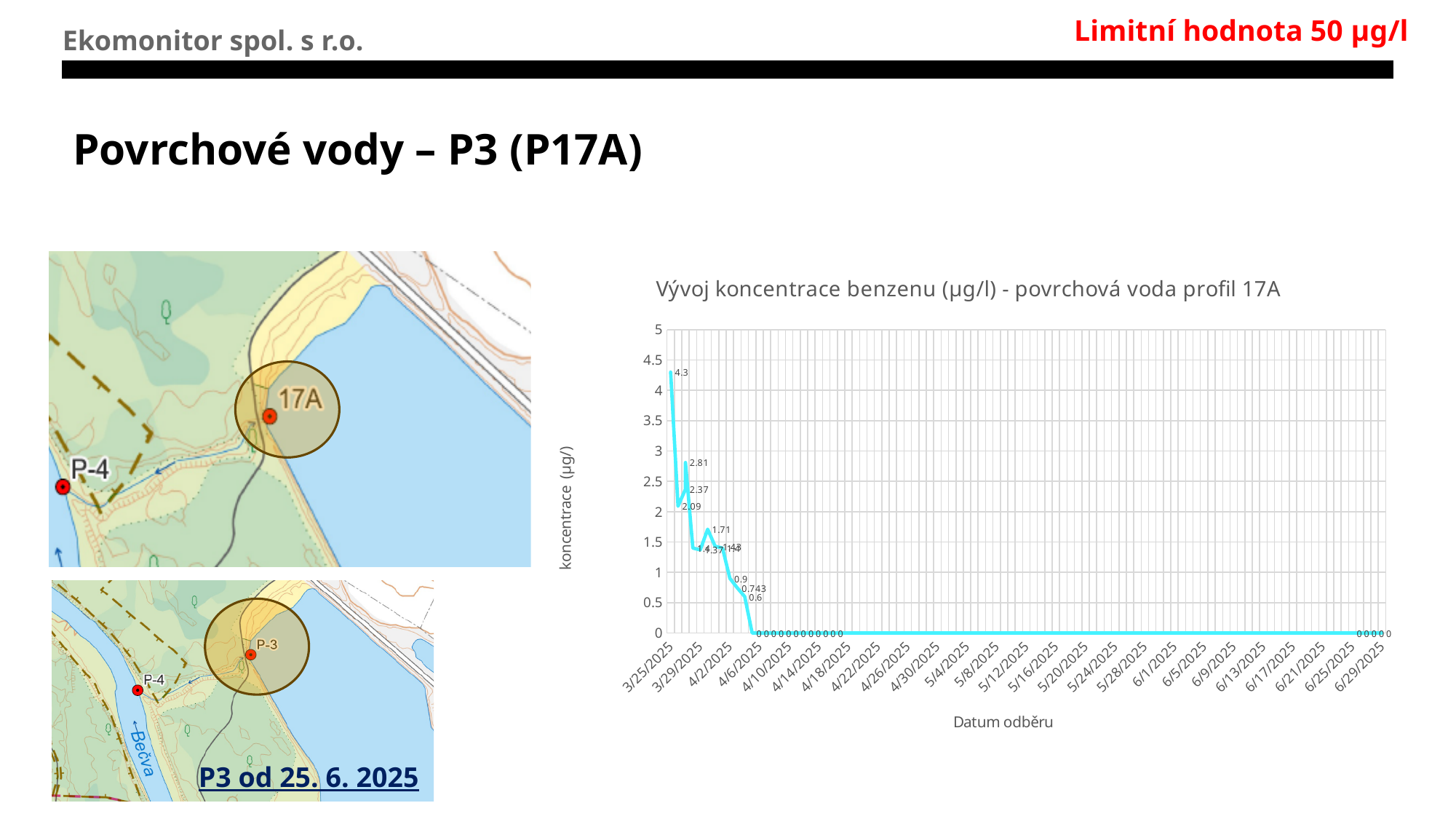
What is the label of the vertical axis of the chart? koncentrace (µg/l) What is the lowest value plotted on the chart? 0 Do the plotted values rise or fall along the x axis from 3/25/2025 onward? fall What is the maximum tick value shown on the vertical axis? 5 What is the difference between the first labelled value (4.3) and the second labelled value (2.81)? 1.49 What is the highest data-labelled value on the chart? 4.3 Is the first plotted value on the chart greater or less than 4? greater What kind of chart is shown on the slide? line chart How many date tick labels are shown on the x axis? 25 Which is larger, the value labelled 2.37 or the value labelled 2.09? 2.37 What is the title of the chart? Vývoj koncentrace benzenu (µg/l) - povrchová voda profil 17A What is the last date label shown on the x axis? 6/29/2025